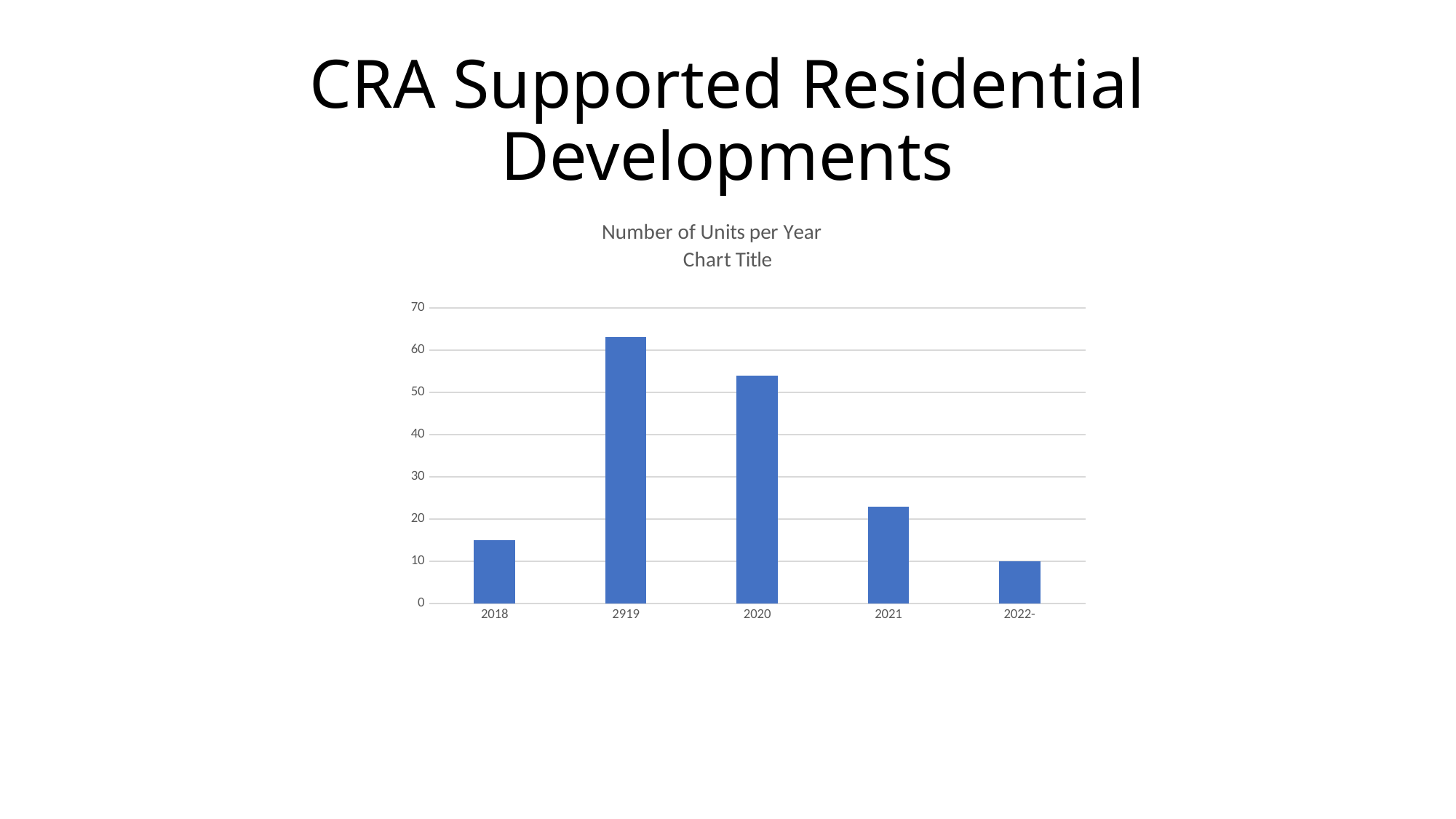
What is the title shown above the chart? Number of Units per Year Is the value for 2919 greater or less than 60? greater How many categories are shown on the x axis of the chart? 5 What kind of chart is shown on the slide? bar chart Is the value for 2020 greater or less than 50? greater Which category has the lowest bar in the chart? 2022- Do the values rise or fall from 2020 to 2022- along the x axis? fall Which category has the highest bar in the chart? 2919 Is the value for 2018 greater or less than 20? less Which is larger, the value for 2018 or the value for 2021? 2021 Which is larger, the value for 2020 or the value for 2021? 2020